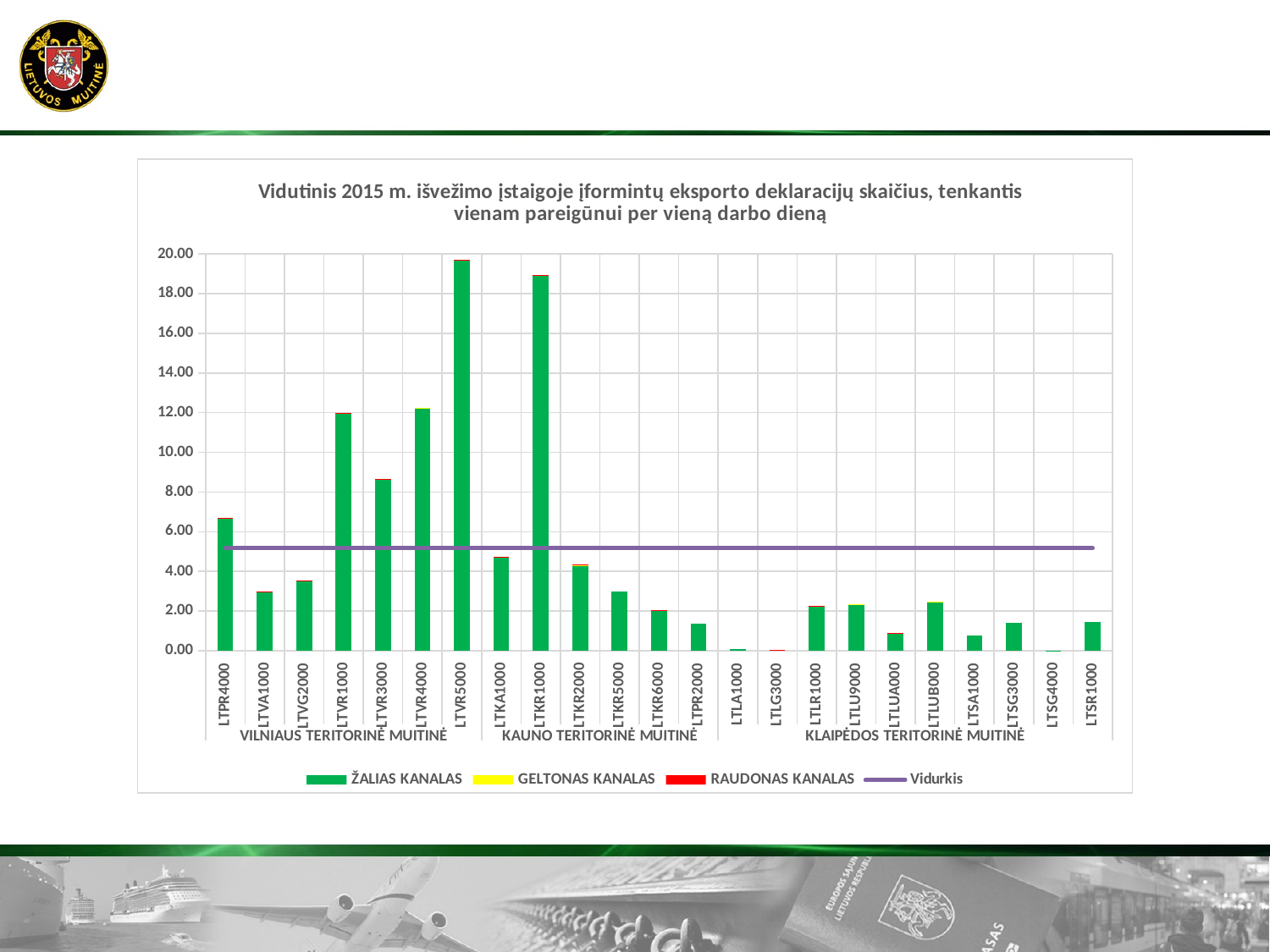
Is the value for LTVR1000 greater or less than 10.00? greater Which category has the highest bar? LTVR5000 How many customs office categories are shown along the x axis? 23 Which has the larger value, LTLUB000 or LTSA1000? LTLUB000 How many series does the legend list? 4 Is the value for LTVA1000 greater or less than 4.00? less What colour represents ŽALIAS KANALAS in the legend? green Which legend entry is drawn as a line rather than bars? Vidurkis Which has the larger value, LTVR1000 or LTVR3000? LTVR1000 What kind of chart is shown on the slide? combination bar and line chart Is the value for LTKR1000 greater or less than 16.00? greater